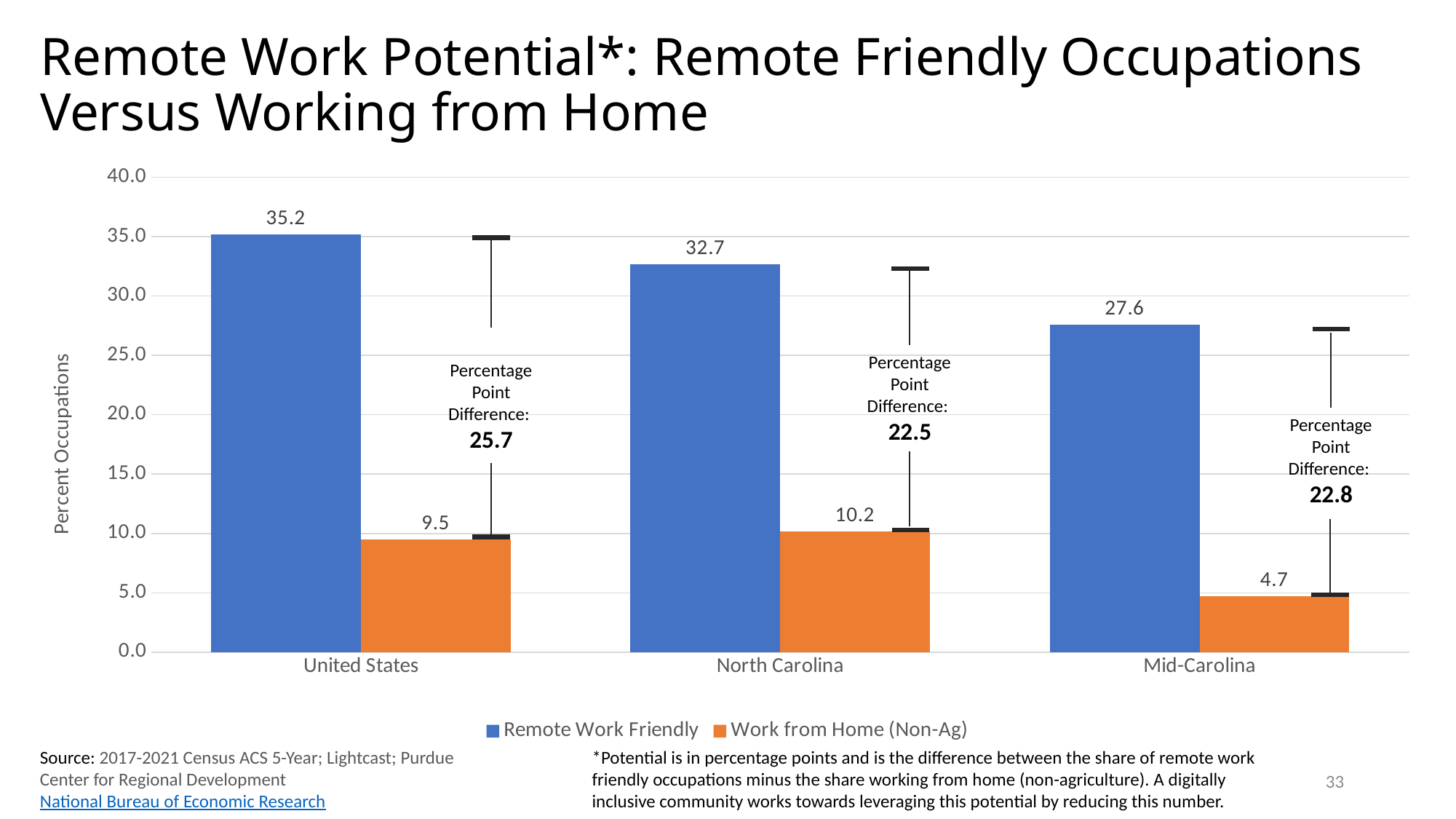
How many series does the legend list? 2 Which is larger, the Work from Home (Non-Ag) value for the United States or for North Carolina? North Carolina What is the difference between the Remote Work Friendly and Work from Home (Non-Ag) values for North Carolina? 22.5 How many regions are shown on the x axis? 3 What is the difference between the Remote Work Friendly values for the United States and Mid-Carolina? 7.6 What is the Remote Work Friendly value for the United States? 35.2 Which region has the highest Remote Work Friendly value? United States Which region has the lowest Work from Home (Non-Ag) value? Mid-Carolina What kind of chart is shown on the slide? bar chart Is the Remote Work Friendly value for Mid-Carolina greater or less than 30.0? less What is the Work from Home (Non-Ag) value for North Carolina? 10.2 What is the Work from Home (Non-Ag) value for Mid-Carolina? 4.7